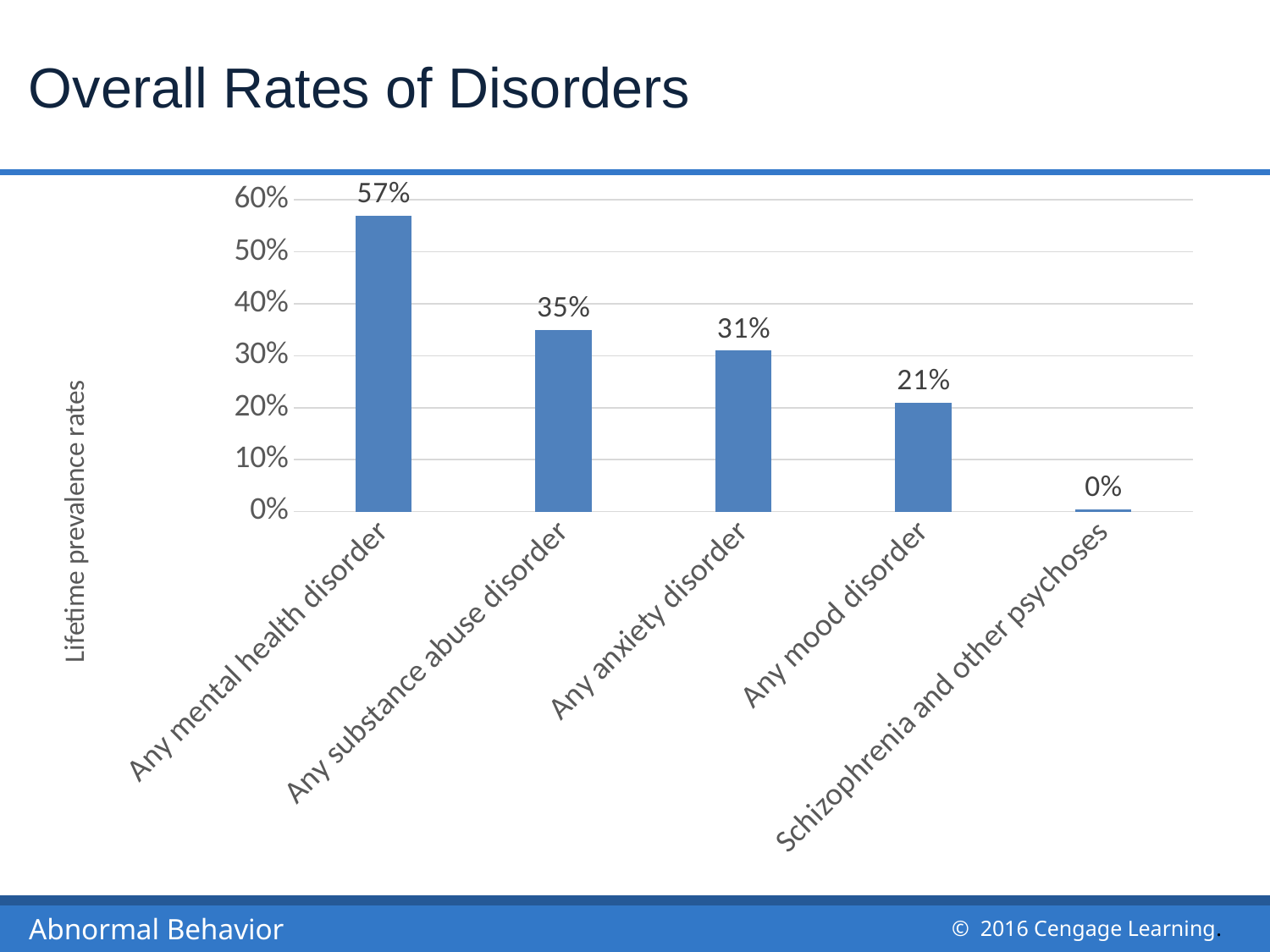
Which is larger, the rate for Any anxiety disorder or Any mood disorder? Any anxiety disorder Is the value for Any anxiety disorder greater or less than 40%? less What is the label on the vertical axis? Lifetime prevalence rates How many categories are shown on the x axis? 5 What kind of chart is shown on the slide? Bar chart What is the value shown for Any mood disorder? 21% What is the value shown for Schizophrenia and other psychoses? 0% Which category has the highest lifetime prevalence rate? Any mental health disorder Which category has the lowest lifetime prevalence rate? Schizophrenia and other psychoses What is the difference between the rates for Any substance abuse disorder and Any anxiety disorder? 4% What is the value shown for Any substance abuse disorder? 35% What is the lifetime prevalence rate for Any mental health disorder? 57%